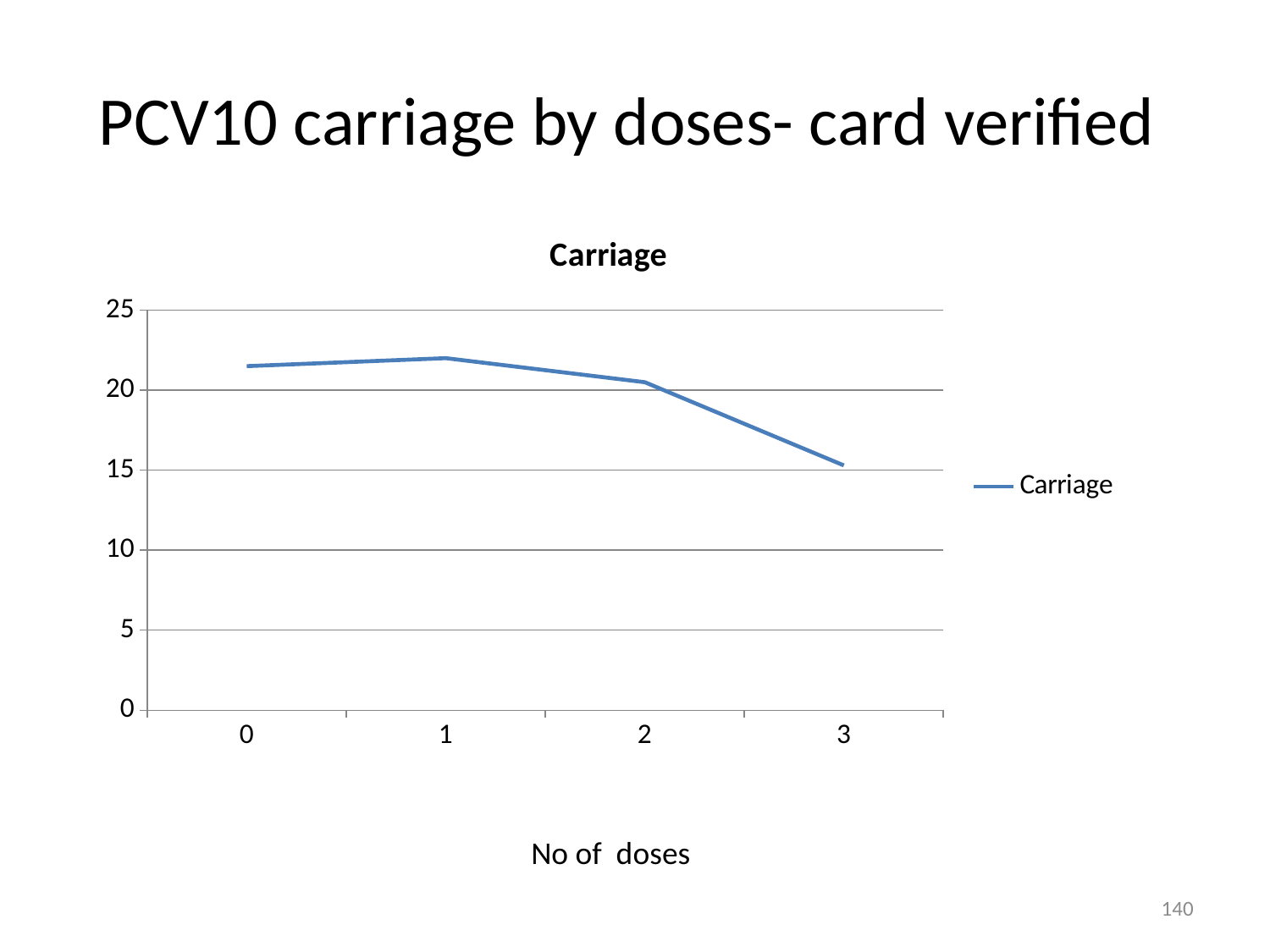
Which has the larger carriage value, 2 doses or 3 doses? 2 doses Is the carriage value for 0 doses greater or less than 20? greater What is the label of the x axis? No of doses Is the carriage value for 3 doses greater or less than 10? greater How many series does the legend list? 1 How many data points are plotted on the Carriage line? 4 What kind of chart is shown on the slide? line chart Which has the larger carriage value, 0 doses or 3 doses? 0 doses Does the carriage value rise or fall between 2 doses and 3 doses? fall Is the carriage value for 1 dose greater or less than 25? less Which number of doses has the lowest carriage value? 3